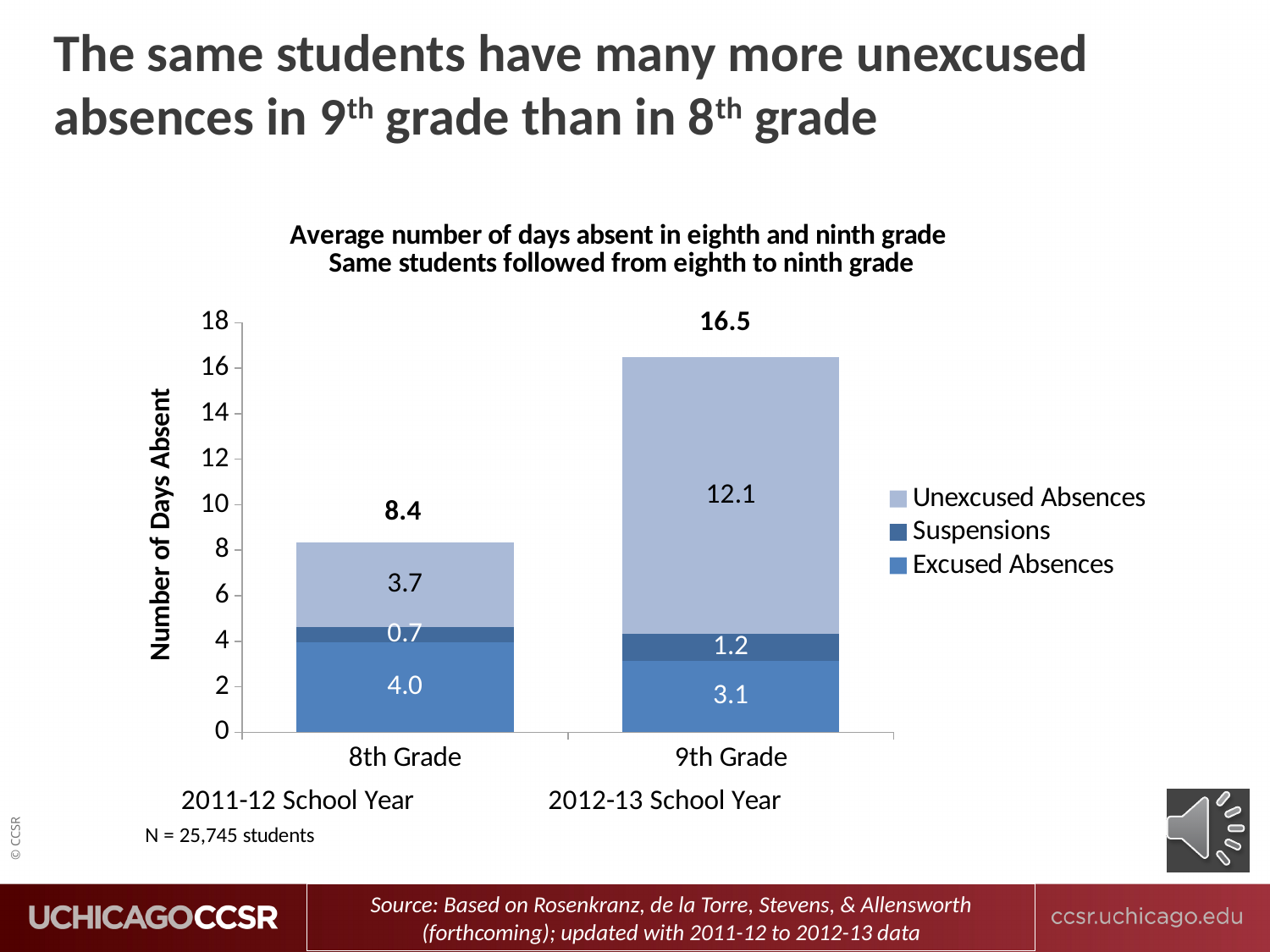
What is the total number of days absent shown for the 9th Grade bar? 16.5 What is the value of Excused Absences for 8th Grade? 4.0 Which grade has the higher total number of days absent? 9th Grade What is the difference in Unexcused Absences between 9th Grade and 8th Grade? 8.4 What is the value of Unexcused Absences for 9th Grade? 12.1 Which grade has the higher value for Excused Absences? 8th Grade How many categories are shown on the x axis? 2 What kind of chart is shown on the slide? Stacked bar chart What is the label of the y axis? Number of Days Absent What is the total number of days absent shown for the 8th Grade bar? 8.4 How many series does the legend list? 3 What is the value of Suspensions for 9th Grade? 1.2